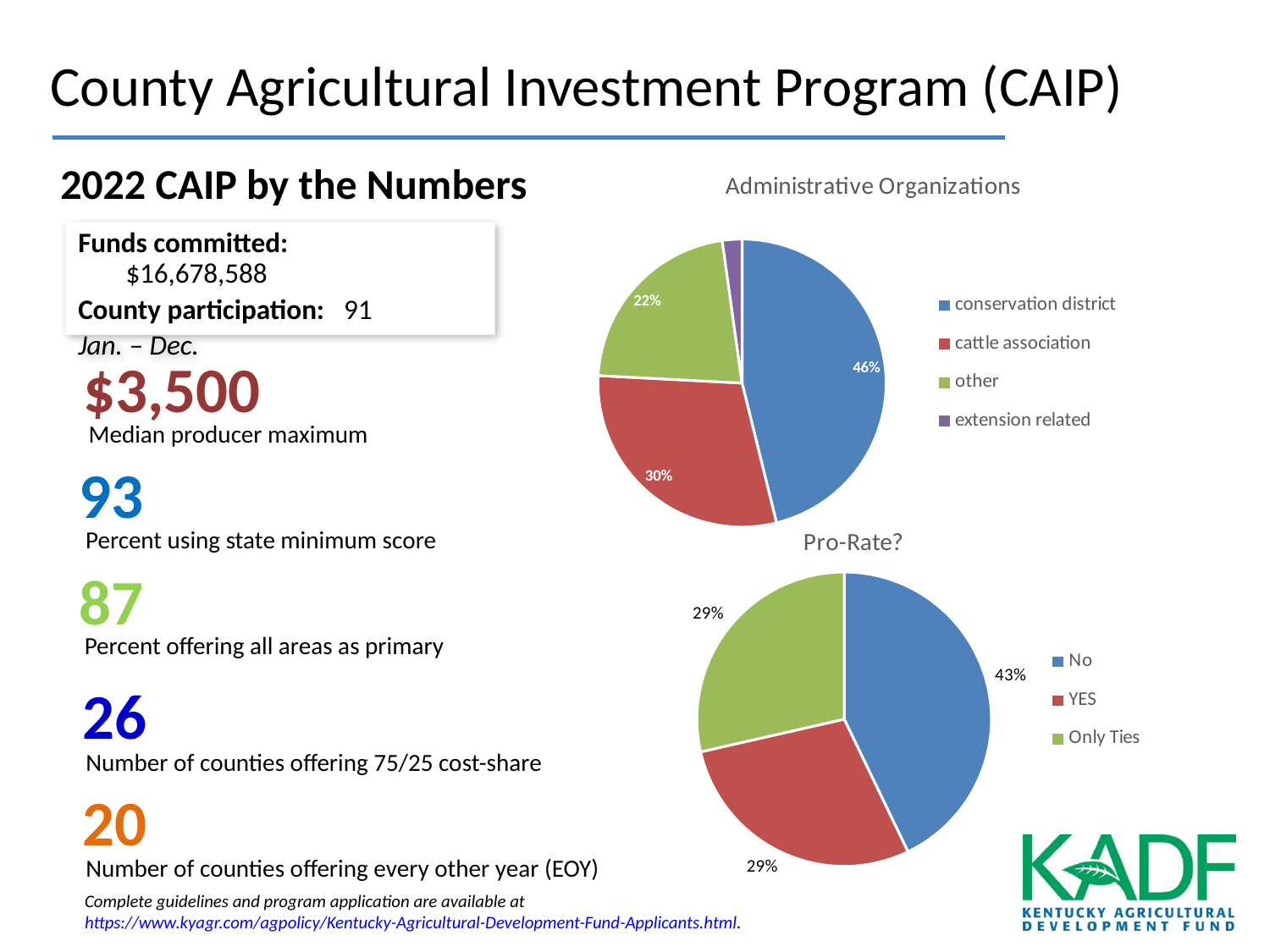
In the Administrative Organizations chart, which category has the largest slice? conservation district In the Administrative Organizations chart, which category has the smallest slice? extension related In the Administrative Organizations chart, what share of the pie is conservation district? 46% In the Pro-Rate? chart, what share of the pie is YES? 29% What type of chart is the Pro-Rate? chart? pie chart In the Administrative Organizations chart, how many categories does the legend list? 4 In the Pro-Rate? chart, which category has the largest slice? No In the Administrative Organizations chart, what share of the pie is cattle association? 30% In the Pro-Rate? chart, what colour is the Only Ties slice? green In the Pro-Rate? chart, what share of the pie is No? 43% In the Administrative Organizations chart, what is the difference in percentage points between conservation district and cattle association? 16 In the Administrative Organizations chart, what share of the pie is other? 22%